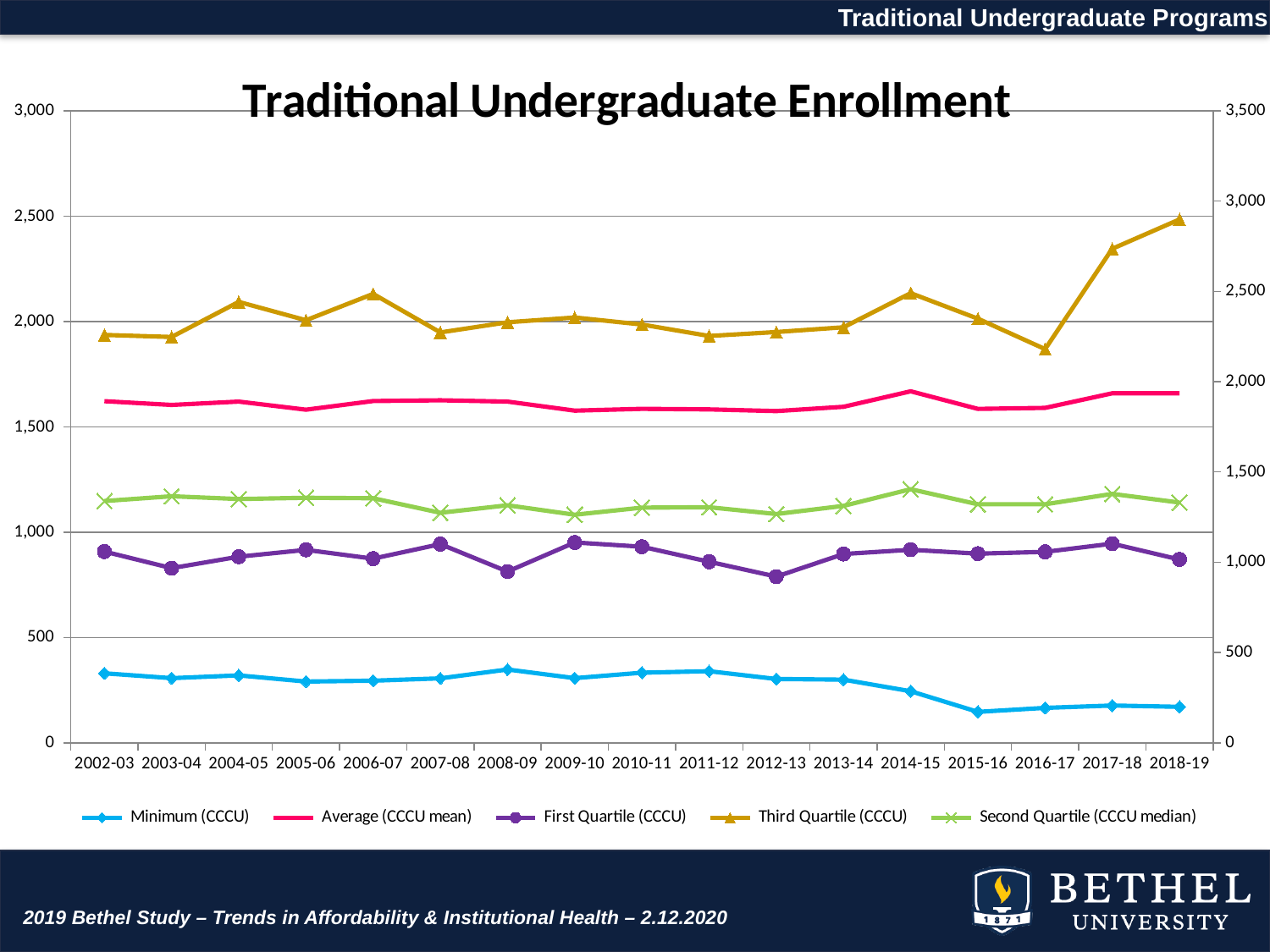
How many academic years are shown along the x axis? 17 What is the title of the chart? Traditional Undergraduate Enrollment In which year does the Third Quartile (CCCU) line reach its highest point? 2018-19 Does the Minimum (CCCU) line rise or fall from 2014-15 to 2015-16? Fall In which year does the Minimum (CCCU) line reach its lowest point? 2015-16 Which series is plotted lowest across all years? Minimum (CCCU) Does the Third Quartile (CCCU) line rise or fall from 2016-17 to 2018-19? Rise What kind of chart is shown on the slide? Line chart Is the value for Minimum (CCCU) in 2018-19 greater or less than 500? less Which series is plotted highest across all years? Third Quartile (CCCU) Is the value for Third Quartile (CCCU) in 2018-19 greater or less than 2,000? greater How many series does the legend list? 5